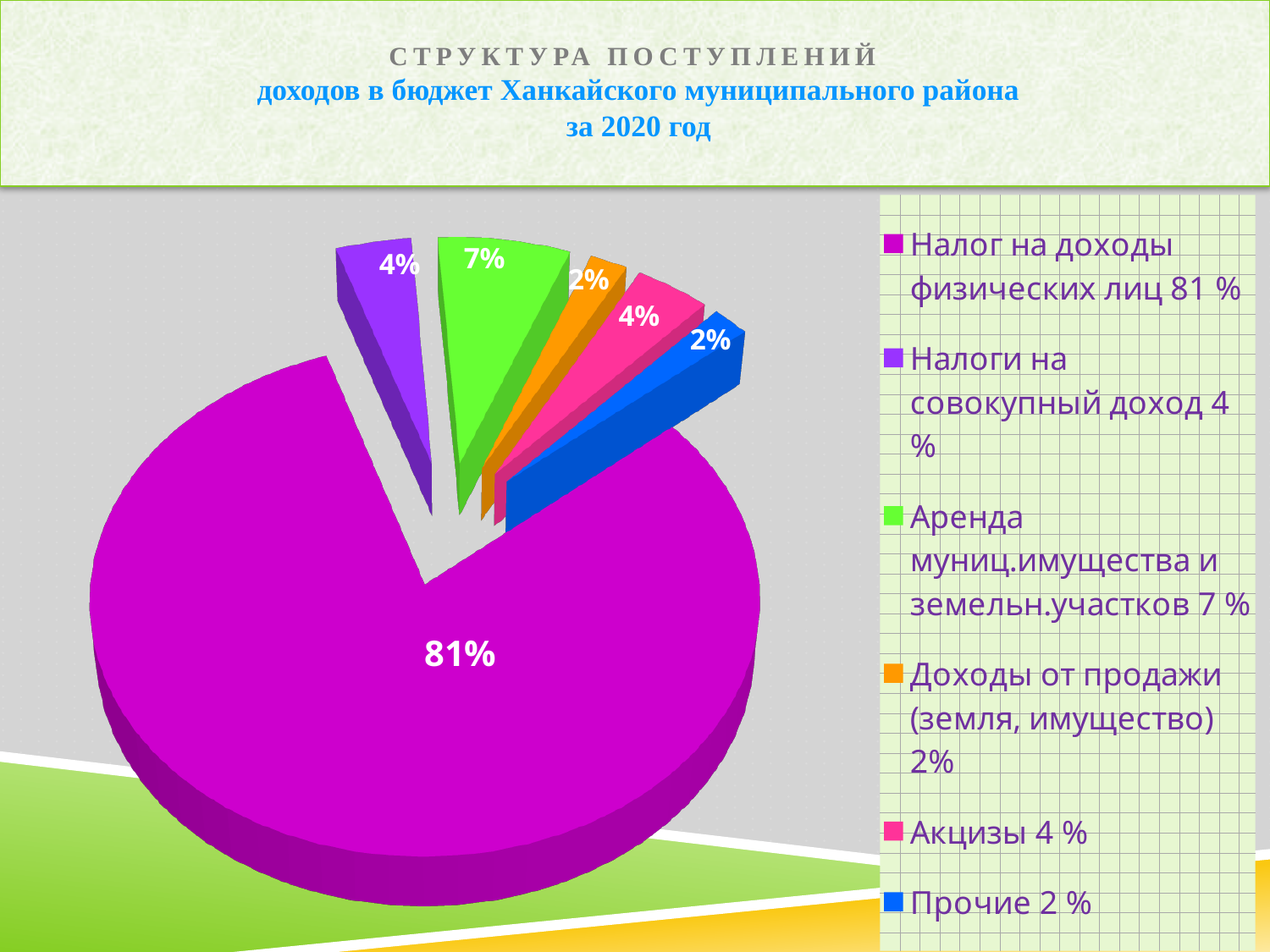
How many entries does the legend list? 6 How many slices does the pie chart have? 6 Which is larger, the share for "Аренда муниц.имущества и земельн.участков" or the share for "Акцизы"? Аренда муниц.имущества и земельн.участков What share of the pie does "Аренда муниц.имущества и земельн.участков" have? 7% What share of the pie does "Акцизы" have? 4% What share of the pie does "Прочие" have? 2% What colour is the slice for "Прочие"? blue Which category has the largest slice of the pie? Налог на доходы физических лиц What is the difference in percentage points between "Налог на доходы физических лиц" and "Аренда муниц.имущества и земельн.участков"? 74 What type of chart is shown on the slide? pie chart